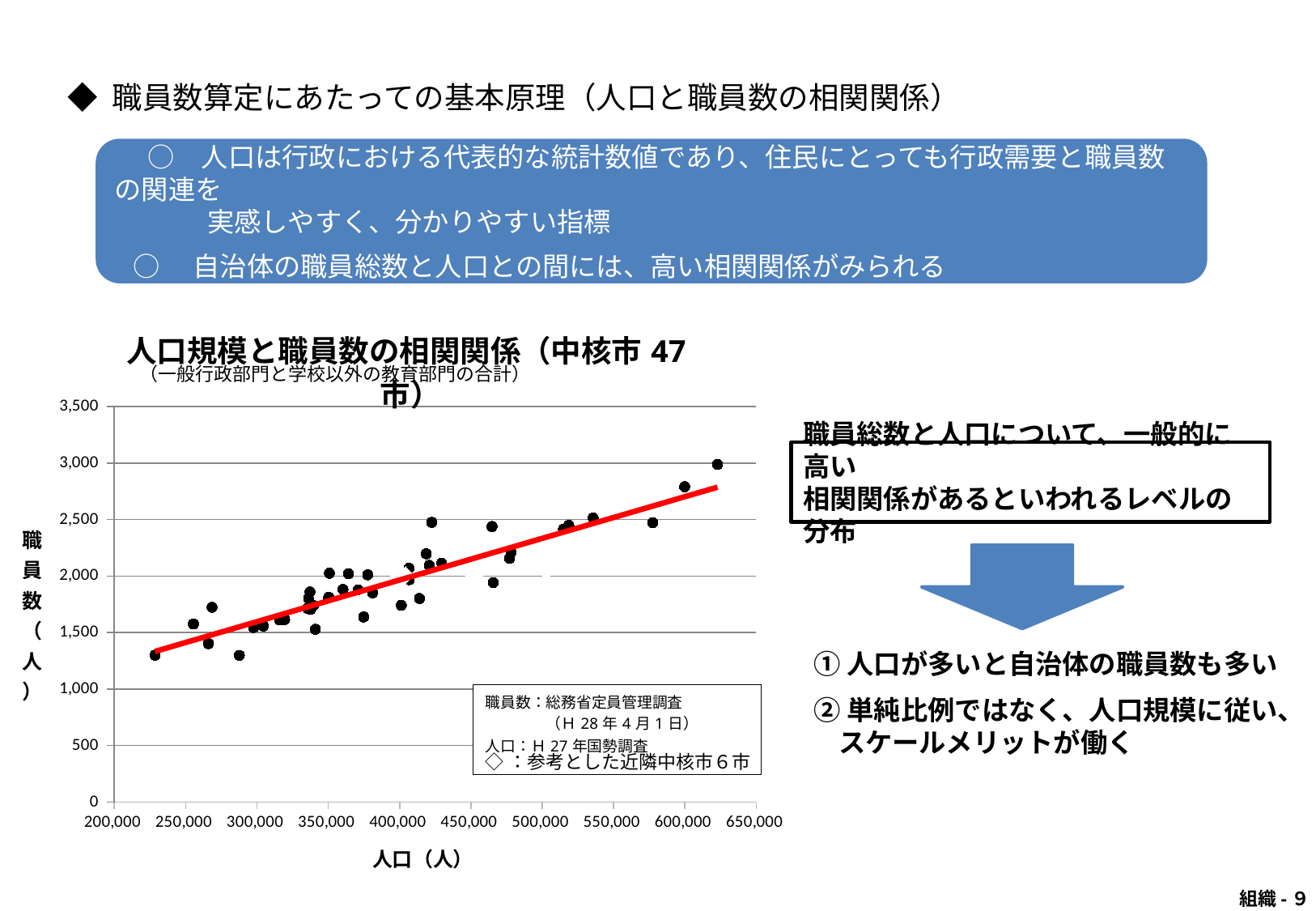
What is the minimum value shown on the x axis? 200,000 Is the staff count for the city with the largest population greater or less than 2,500? greater What kind of chart is shown on the slide? Scatter chart What is the label of the x axis? 人口（人） Do the plotted staff counts generally rise or fall as population increases along the x axis? Rise According to the chart title, how many core cities (中核市) are plotted? 47 Is the staff count for the city with the smallest population greater or less than 1,500? less Which point has the highest staff count: the one with the largest population or the one with the smallest population? The one with the largest population What is the maximum value shown on the y axis? 3,500